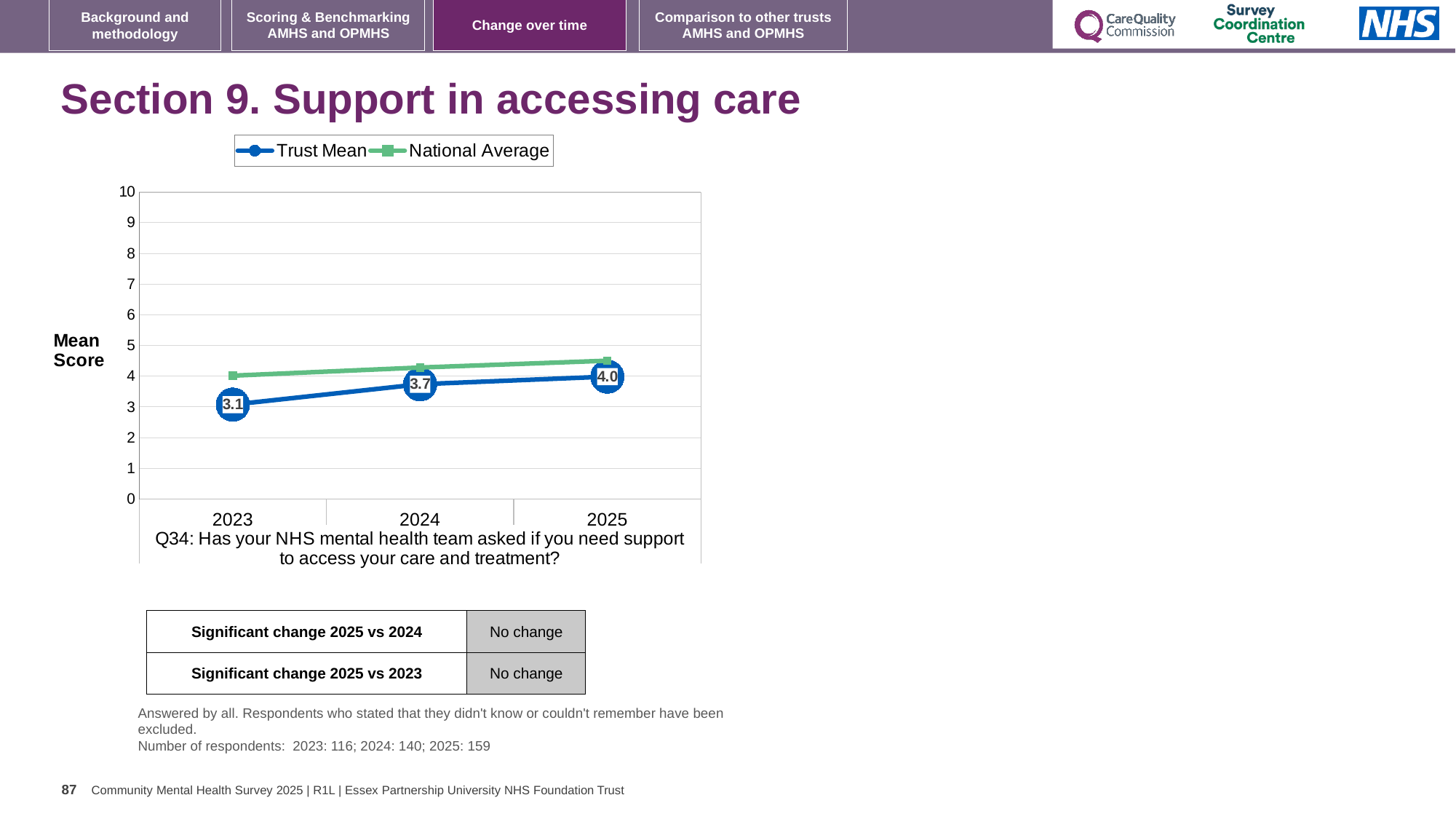
What is the Trust Mean score for 2024? 3.7 What kind of chart is shown on the slide? Line chart In which year is the Trust Mean highest? 2025 How many years are shown on the x axis? 3 In which year is the Trust Mean lowest? 2023 What is the Trust Mean score for 2023? 3.1 How many series does the legend list? 2 Is the National Average value for 2025 greater or less than 5? less What is the Trust Mean score for 2025? 4.0 In 2023, which is higher: the Trust Mean or the National Average? National Average By how much did the Trust Mean increase from 2023 to 2025? 0.9 Does the Trust Mean rise or fall from 2023 to 2025? Rise